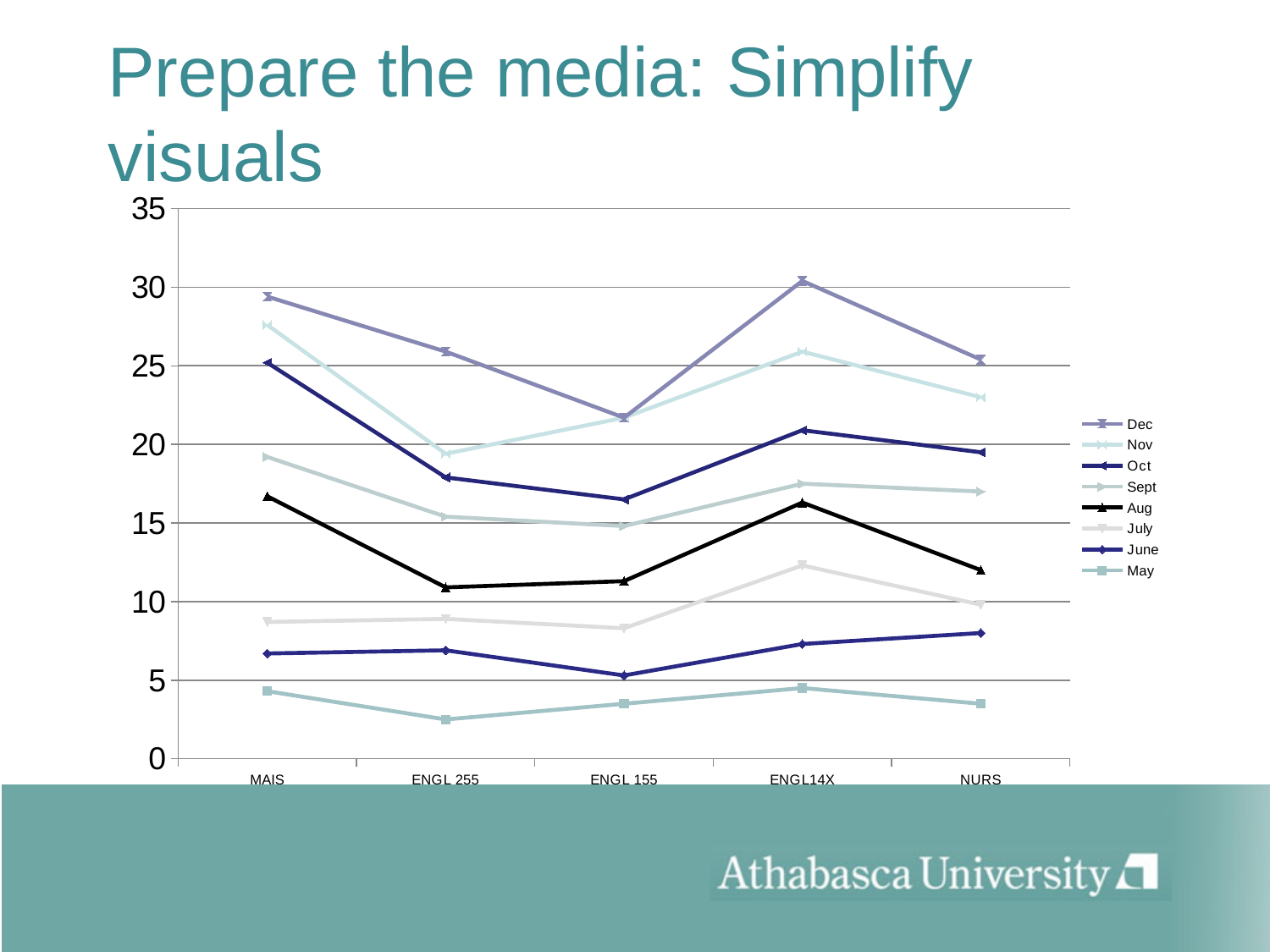
What kind of chart is shown on the slide? line chart How many categories are shown on the x axis of the chart? 5 For the May series, which category has the lowest value? ENGL 255 At MAIS, which is larger: the Dec value or the Nov value? Dec Which series has the lowest values across all categories in the chart? May Which series has the highest value at ENGL14X? Dec Is the value for May at ENGL 255 greater or less than 5? less Is the value for Dec at MAIS greater or less than 25? greater How many series does the chart's legend list? 8 Is the value for July at ENGL14X greater or less than 10? greater Does the Dec series rise or fall from ENGL 155 to ENGL14X? rise For the Dec series, which category has the lowest value? ENGL 155